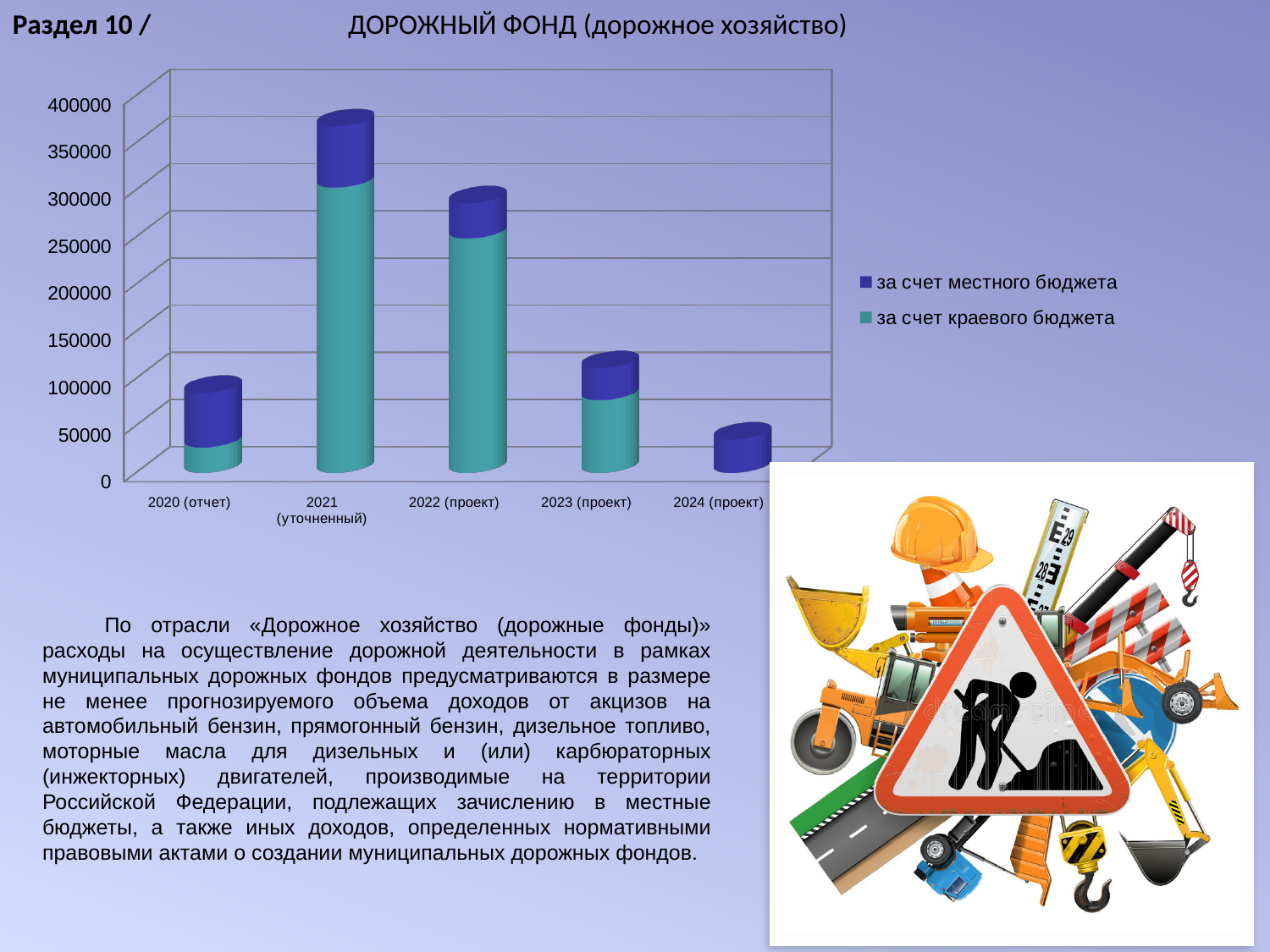
Which year has the lowest total bar in the chart? 2024 (проект) Is the total value for 2024 (проект) greater or less than 100000? less Which year has the highest total bar in the chart? 2021 (уточненный) What kind of chart is shown on the slide? stacked bar chart How many year categories are shown on the x axis of the chart? 5 Which total bar is taller, 2022 (проект) or 2023 (проект)? 2022 (проект) Is the total value for 2023 (проект) greater or less than 150000? less Do the total bar values rise or fall from 2021 (уточненный) to 2024 (проект)? fall Which series is shown in dark blue in the chart legend? за счет местного бюджета Is the total value for 2020 (отчет) greater or less than 50000? greater How many series does the chart legend list? 2